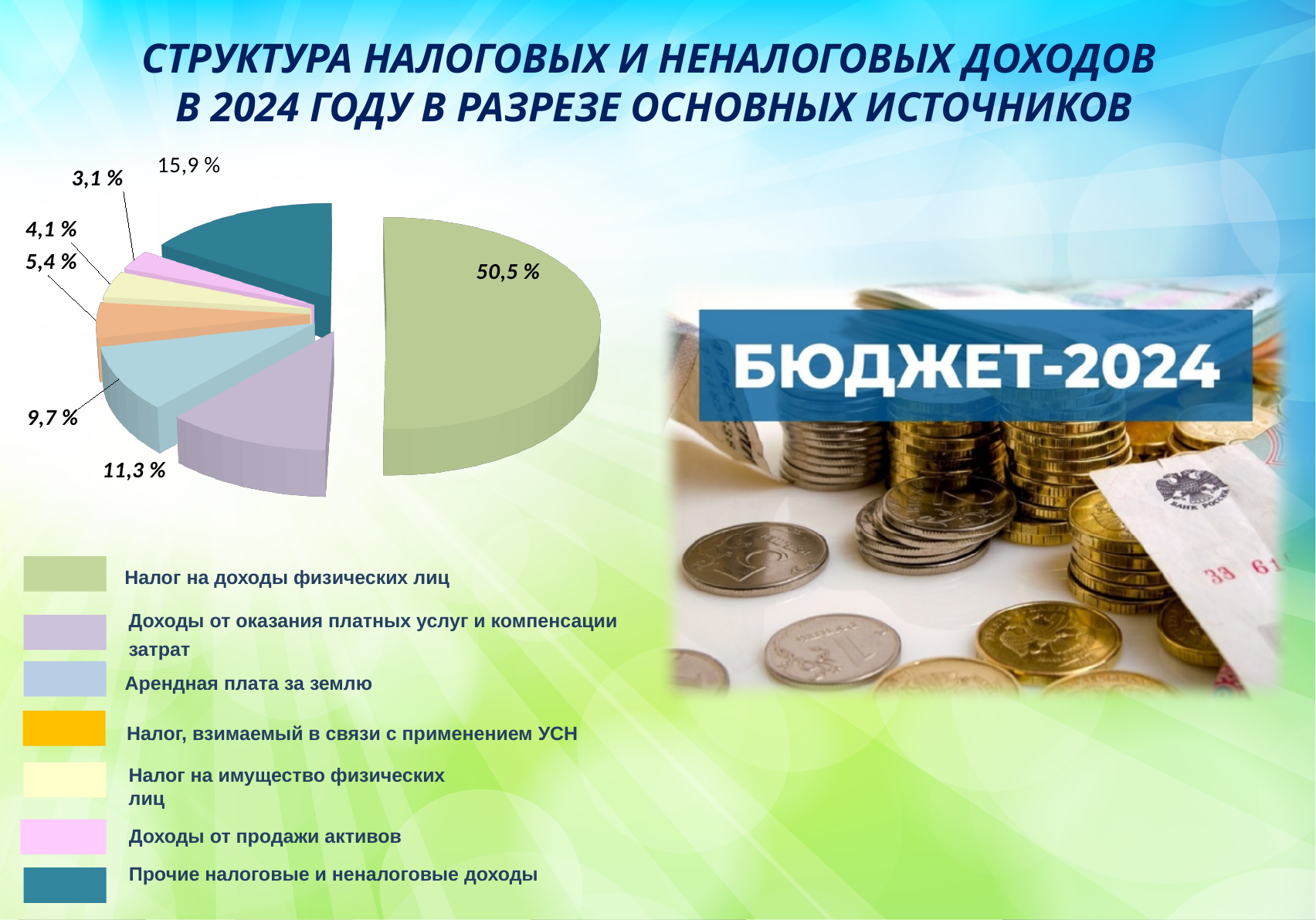
Which category has the smallest slice of the pie chart? Доходы от продажи активов How many slices does the pie chart have? 7 Which category is shown in teal (dark blue-green) in the legend? Прочие налоговые и неналоговые доходы What share of the pie chart does 'Налог на доходы физических лиц' have? 50,5 % What is the difference between the shares of 'Прочие налоговые и неналоговые доходы' and 'Доходы от оказания платных услуг и компенсации затрат'? 4,6 % What share does 'Прочие налоговые и неналоговые доходы' have in the pie chart? 15,9 % What kind of chart is shown on the slide? Pie chart What share does 'Доходы от оказания платных услуг и компенсации затрат' have in the pie chart? 11,3 % Which is larger: the share of 'Арендная плата за землю' or the share of 'Налог, взимаемый в связи с применением УСН'? Арендная плата за землю Which category has the largest slice of the pie chart? Налог на доходы физических лиц What share does 'Доходы от продажи активов' have in the pie chart? 3,1 % What share does 'Арендная плата за землю' have in the pie chart? 9,7 %